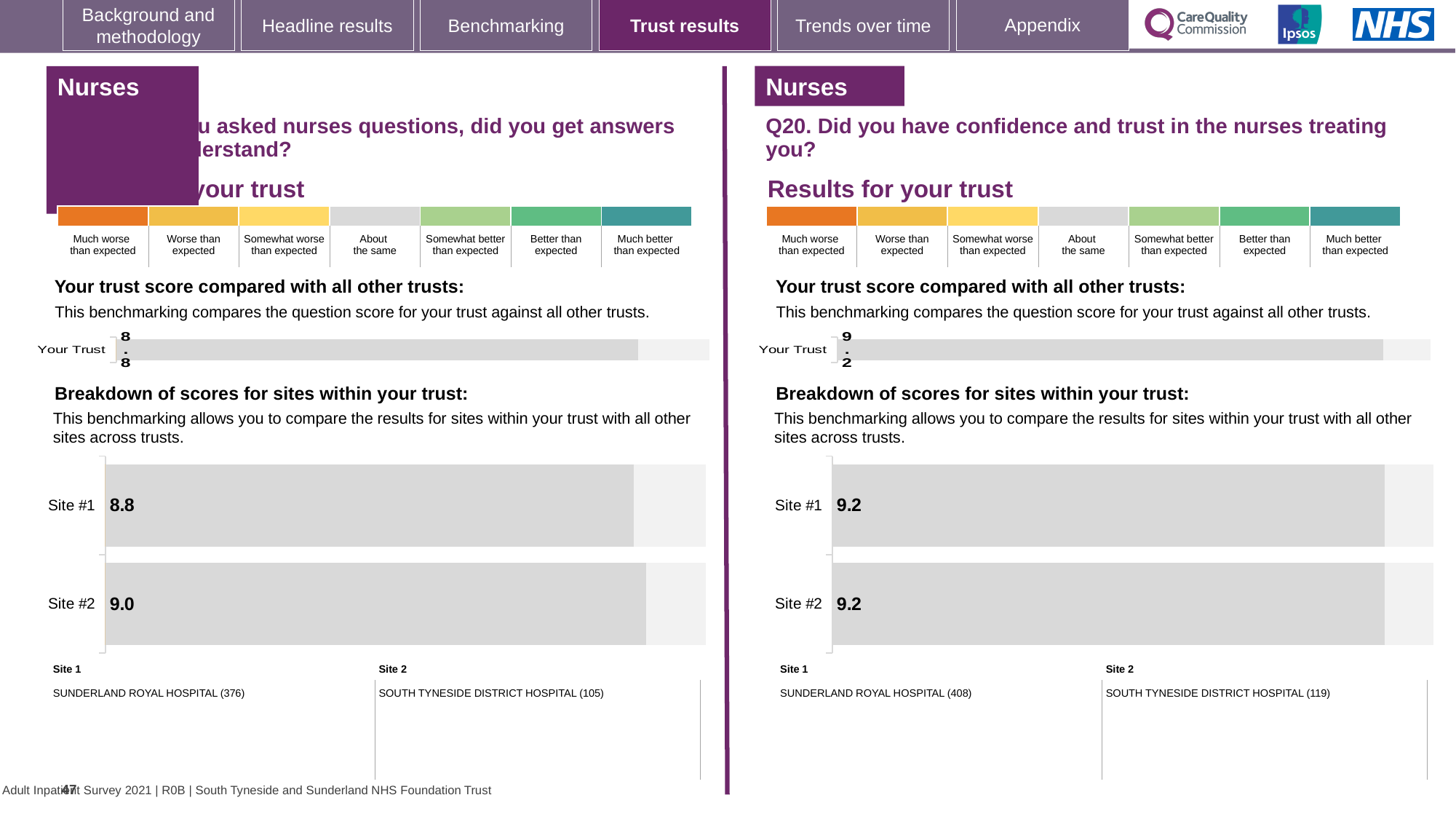
What type of chart is used for the breakdown of scores for sites within your trust on the left-hand side of the slide? Bar chart In the left-hand site breakdown chart, what is the difference between the Site #2 score and the Site #1 score? 0.2 How many sites are shown in the right-hand (Q20) site breakdown chart? 2 On the left-hand side of the slide, what is the score shown for Site #1 in the breakdown of scores for sites within your trust? 8.8 In the right-hand (Q20) site breakdown chart, what is the difference between the Site #1 score and the Site #2 score? 0.0 On the left-hand side of the slide, what is the 'Your Trust' score in the chart comparing the trust score with all other trusts? 8.8 In the left-hand site breakdown chart, which site has the higher score? Site #2 Which is larger: the 'Your Trust' score on the left-hand side of the slide or the 'Your Trust' score on the right-hand side (Q20)? The right-hand (Q20) score, 9.2 On the right-hand side of the slide (Q20), what is the score shown for Site #2 in the breakdown of scores for sites within your trust? 9.2 On the right-hand side of the slide (Q20), what is the score shown for Site #1 in the breakdown of scores for sites within your trust? 9.2 On the right-hand side of the slide (Q20), what is the 'Your Trust' score in the chart comparing the trust score with all other trusts? 9.2 On the left-hand side of the slide, what is the score shown for Site #2 in the breakdown of scores for sites within your trust? 9.0